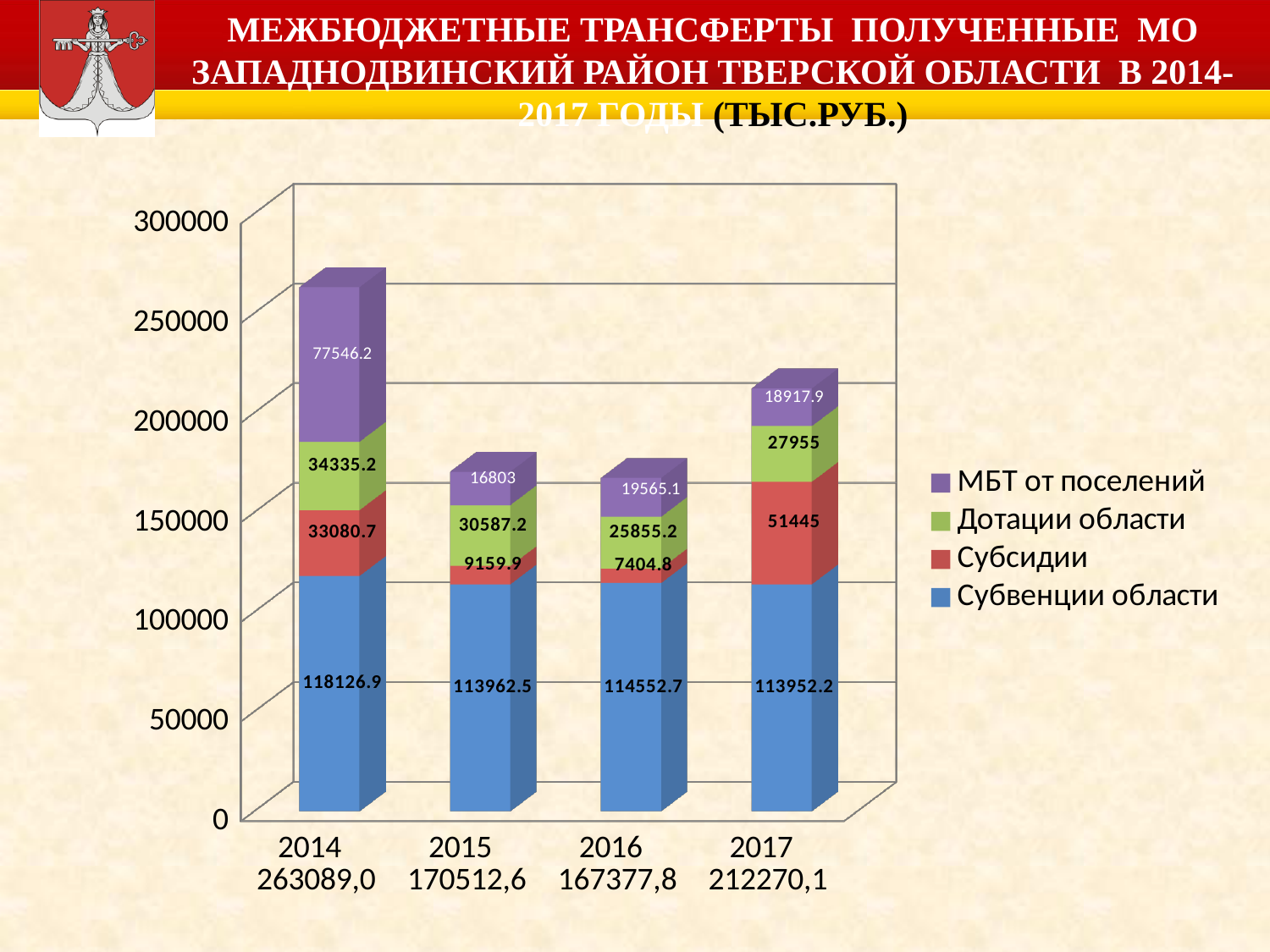
Which year has the highest value for МБТ от поселений? 2014 What kind of chart is shown on the slide? Stacked bar chart What is the value of Дотации области for 2016? 25855.2 Which year has the lowest value for Субсидии? 2016 Which is larger: Дотации области in 2015 or Дотации области in 2017? 2015 What is the value of Субвенции области for 2014? 118126.9 What is the total of the stacked bar for 2014, as printed on the slide? 263089,0 How many years are shown on the x axis? 4 How many series does the legend list? 4 What is the value of МБТ от поселений for 2015? 16803 What is the difference between the Субсидии values for 2017 and 2016? 44040.2 What is the value of Субсидии for 2017? 51445